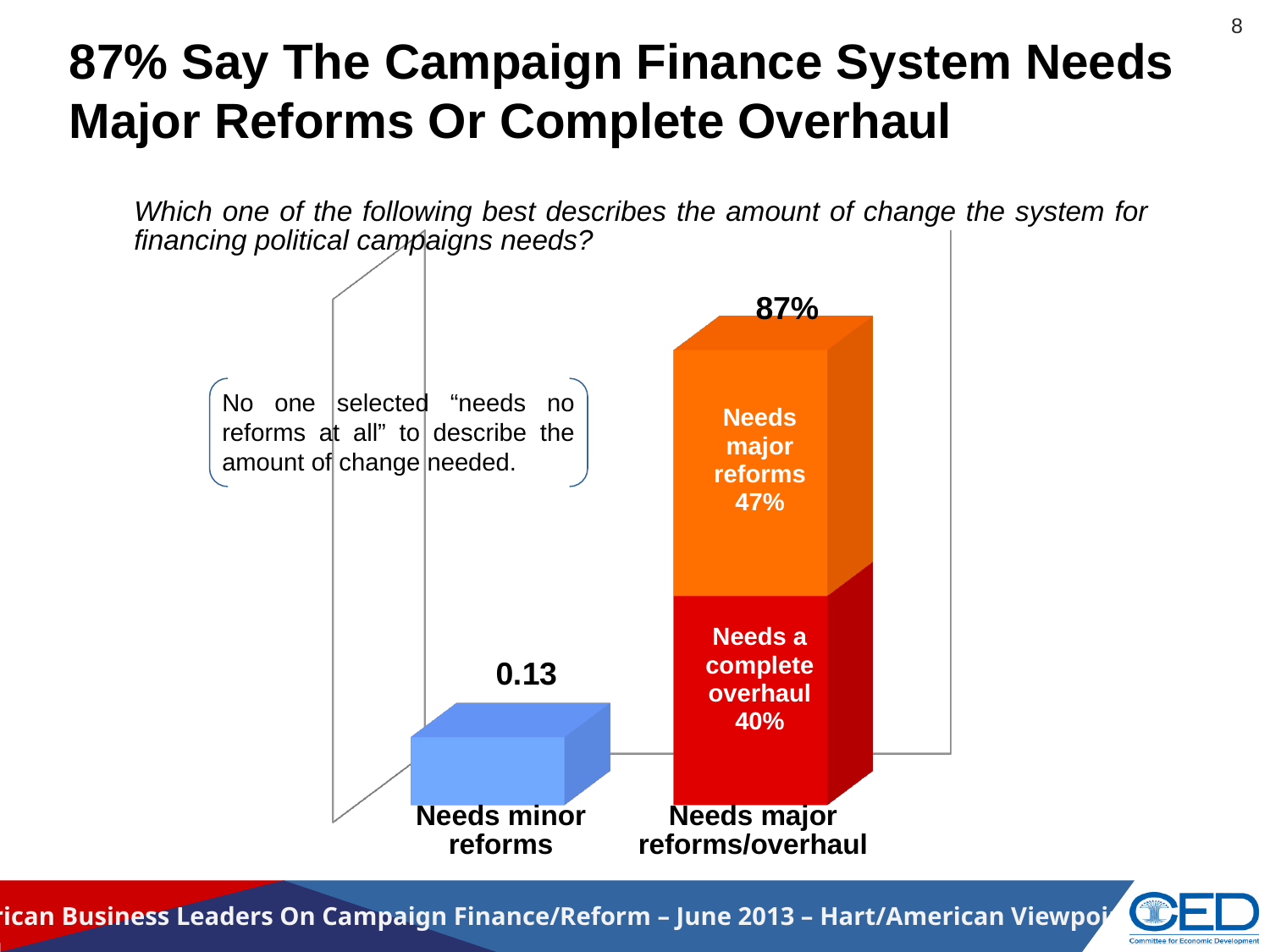
What is the total shown for the "Needs major reforms/overhaul" stacked bar? 87% Which category has the lowest value? Needs minor reforms What colour is the "Needs a complete overhaul" segment? Red Which category has the highest value? Needs major reforms/overhaul What percentage is shown for the "Needs major reforms" segment? 47% Which segment is larger, "Needs major reforms" or "Needs a complete overhaul"? Needs major reforms What is the difference between the "Needs major reforms" segment and the "Needs a complete overhaul" segment? 7% What value is shown for the "Needs minor reforms" bar? 0.13 What kind of chart is shown on the slide? Bar chart How many categories are shown on the x axis? 2 According to the text box on the chart, which option did no one select? Needs no reforms at all What percentage is shown for the "Needs a complete overhaul" segment? 40%